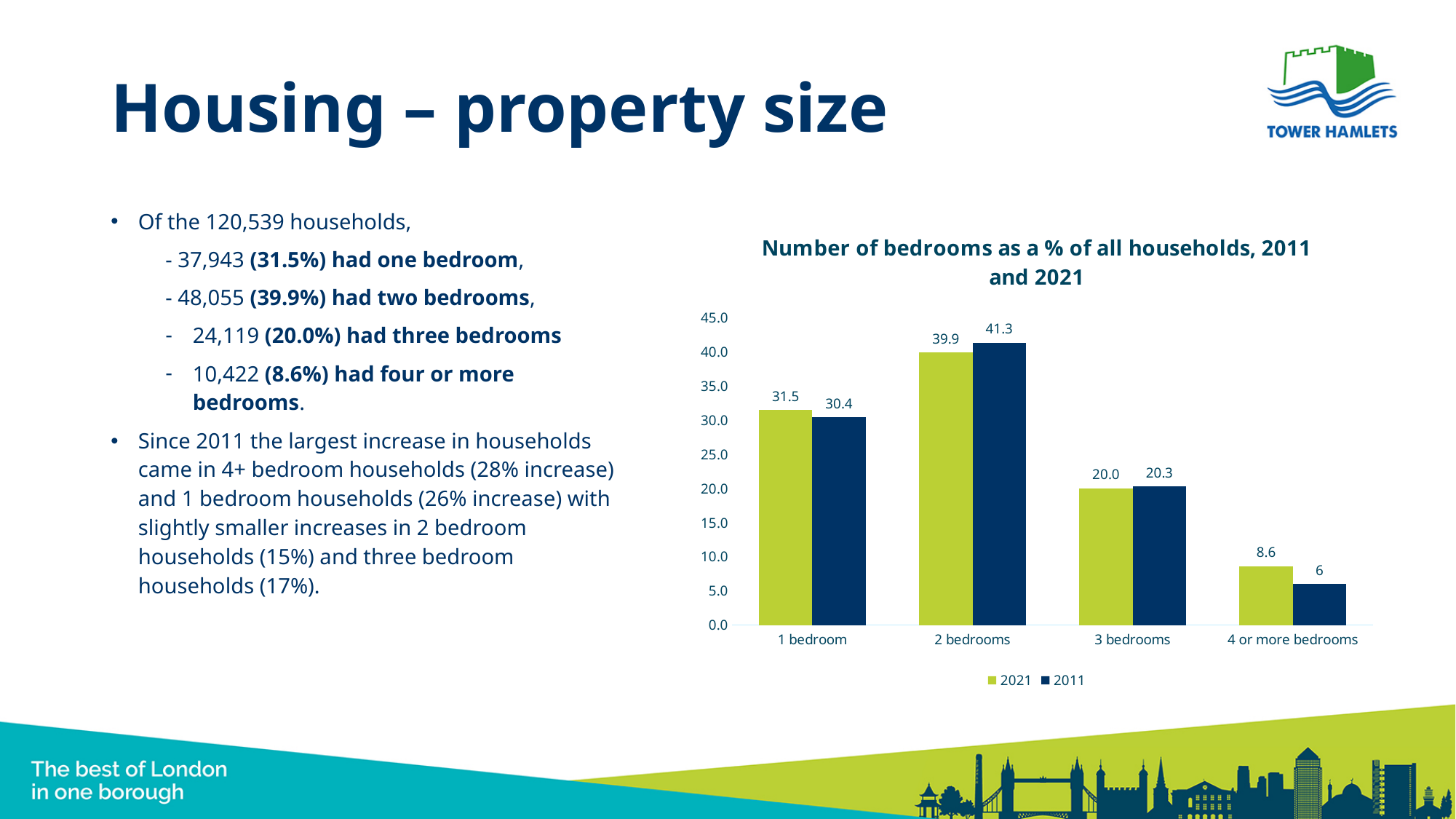
What is the 2011 value for 2 bedrooms? 41.3 How many series does the legend list? 2 What kind of chart is shown on the slide? bar chart What is the 2021 value for 1 bedroom? 31.5 For 3 bedrooms, which year has the larger value, 2021 or 2011? 2011 Is the 2021 value for 3 bedrooms greater or less than 25.0? less Which category has the highest 2021 value? 2 bedrooms What is the difference between the 2011 and 2021 values for 2 bedrooms? 1.4 What is the 2011 value for 4 or more bedrooms? 6 How many bedroom categories are shown on the x axis? 4 Which category has the lowest 2011 value? 4 or more bedrooms What is the title of the chart? Number of bedrooms as a % of all households, 2011 and 2021